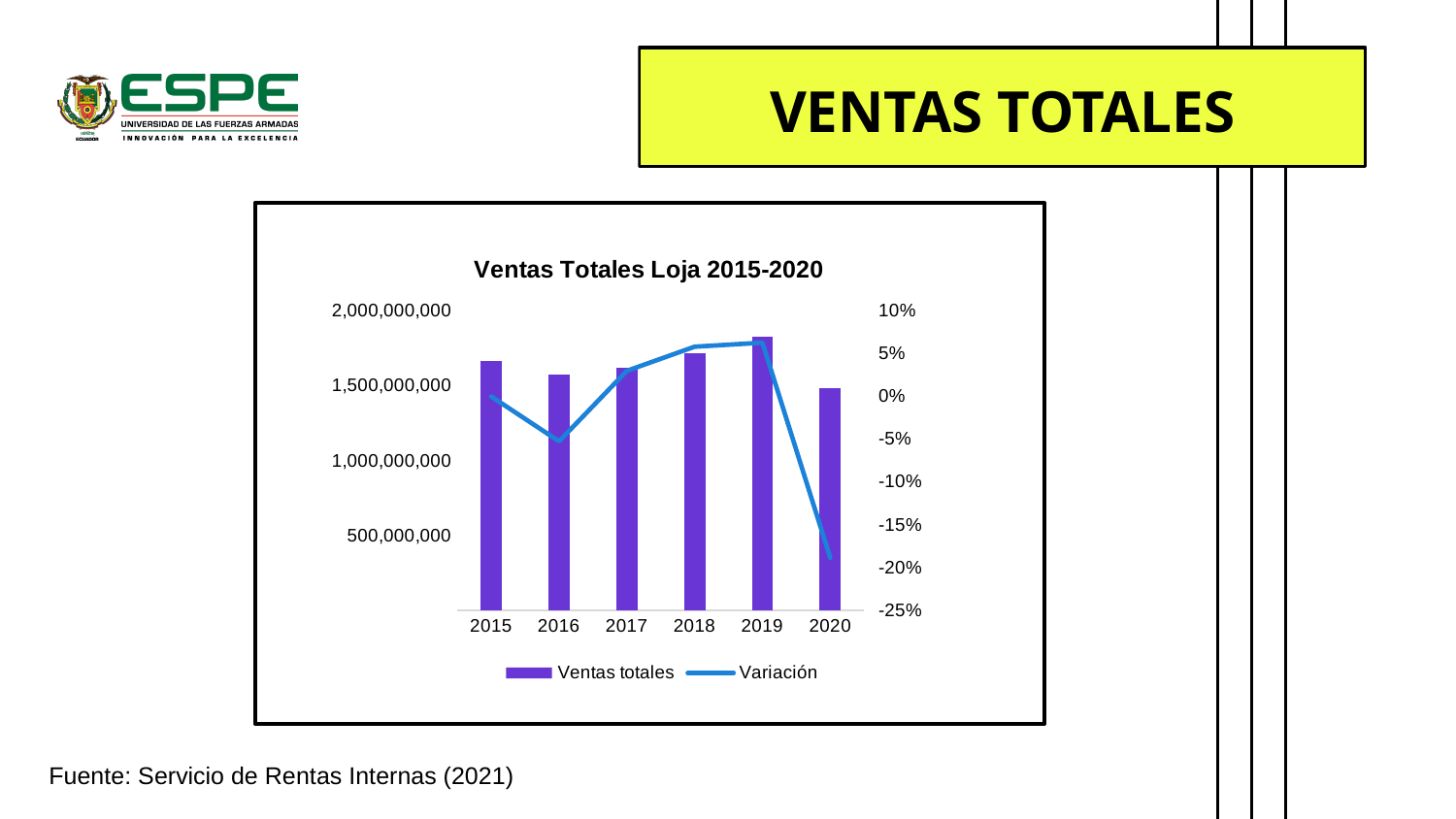
How many series does the legend list? 2 What are the two series named in the legend? Ventas totales and Variación Which year has the lowest Ventas totales bar? 2020 How many years are shown on the x axis? 6 Which year has the lowest Variación value? 2020 Is the Variación value for 2016 greater or less than 0%? less Is the Variación value for 2020 greater or less than -15%? less Is the Ventas totales value for 2019 greater or less than 1,500,000,000? greater What kind of chart is shown on the slide? A combined bar and line chart What is the title of the chart? Ventas Totales Loja 2015-2020 Which year has the larger Ventas totales bar, 2015 or 2016? 2015 Which year has the highest Ventas totales bar? 2019